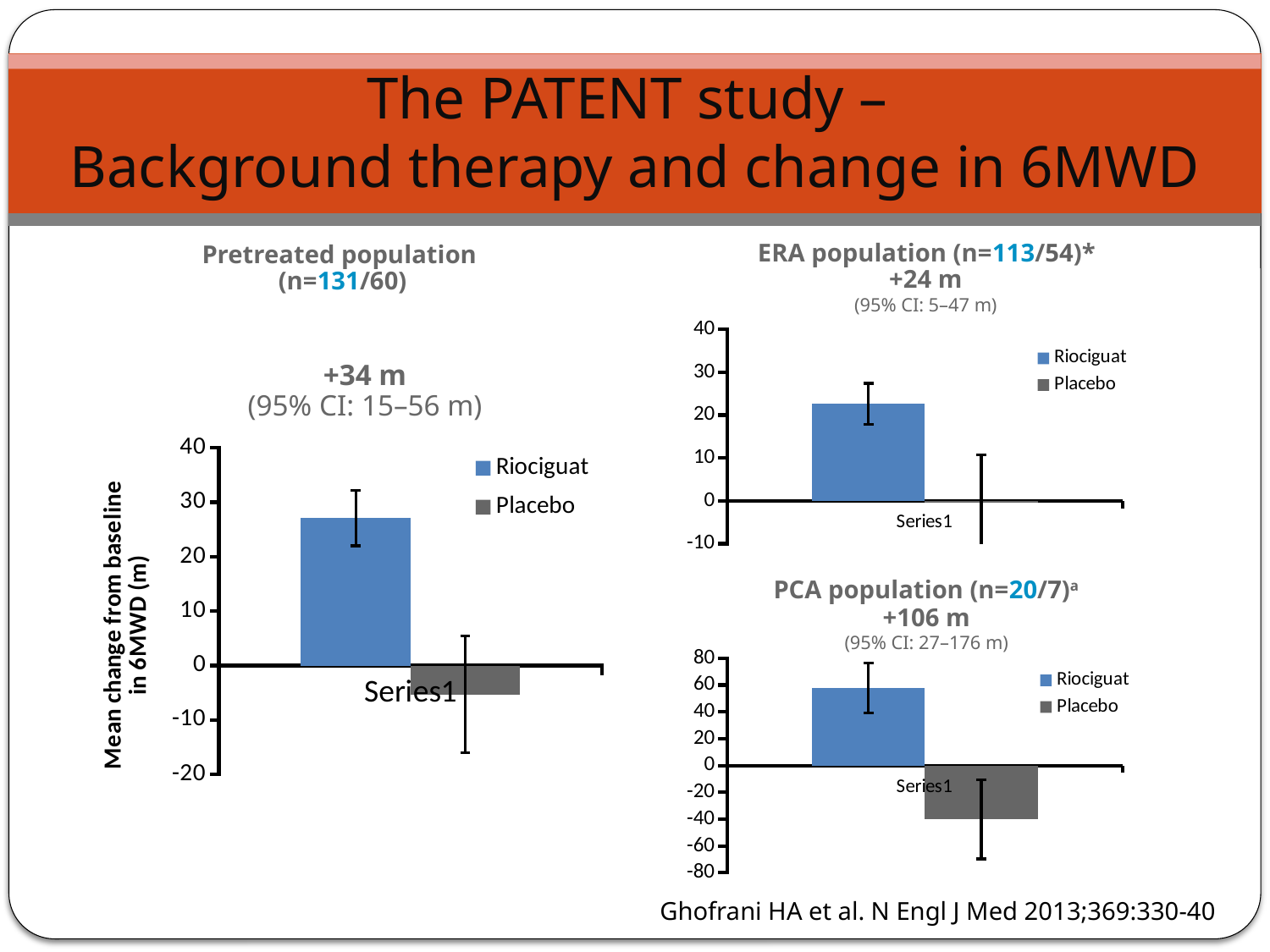
What kind of chart is the Pretreated population chart? bar chart In the ERA population chart, is the value for Riociguat greater or less than 10? greater In the PCA population chart, is the value for Riociguat greater or less than 40? greater In the ERA population chart, which is larger, Riociguat or Placebo? Riociguat In the Pretreated population chart, is the value for Riociguat greater or less than 30? less In the Pretreated population chart, which is larger, Riociguat or Placebo? Riociguat How many series does the legend of the ERA population chart list? 2 What is the y-axis label of the Pretreated population chart? Mean change from baseline in 6MWD (m) In the PCA population chart, which is larger, Riociguat or Placebo? Riociguat